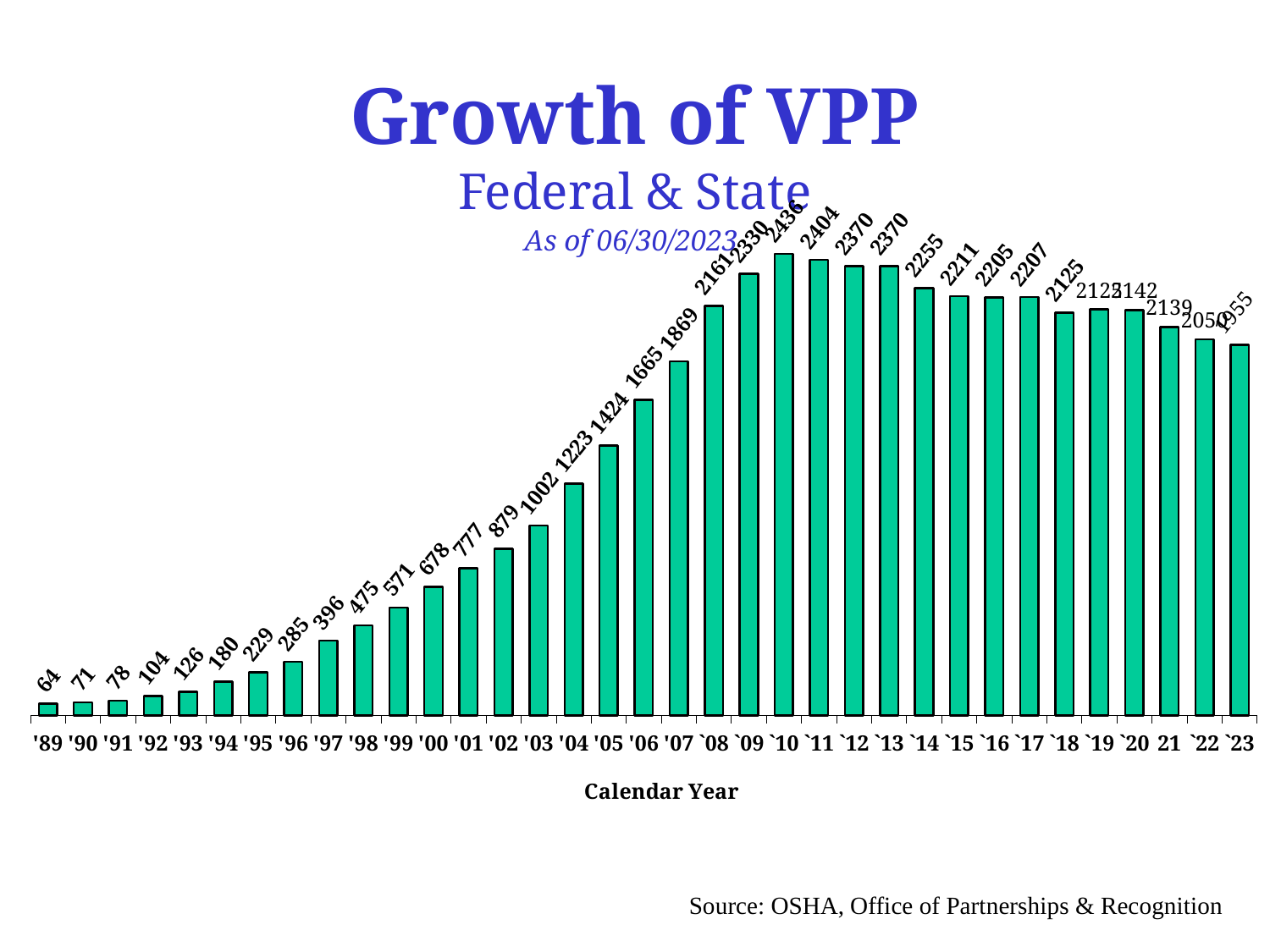
Do the values rise or fall from '89 to '10? rise What is the value for '17? 2207 Which is larger, the value for '14 or the value for '15? '14 What is the value for '05? 1424 What kind of chart is this? bar chart What is the difference between the values for '07 and '06? 204 What is the difference between the values for '10 and '11? 32 Which year has the highest value? '10 What is the title of the x axis? Calendar Year How many years are shown on the x axis? 35 What is the value for '89? 64 Which year has the lowest value? '89